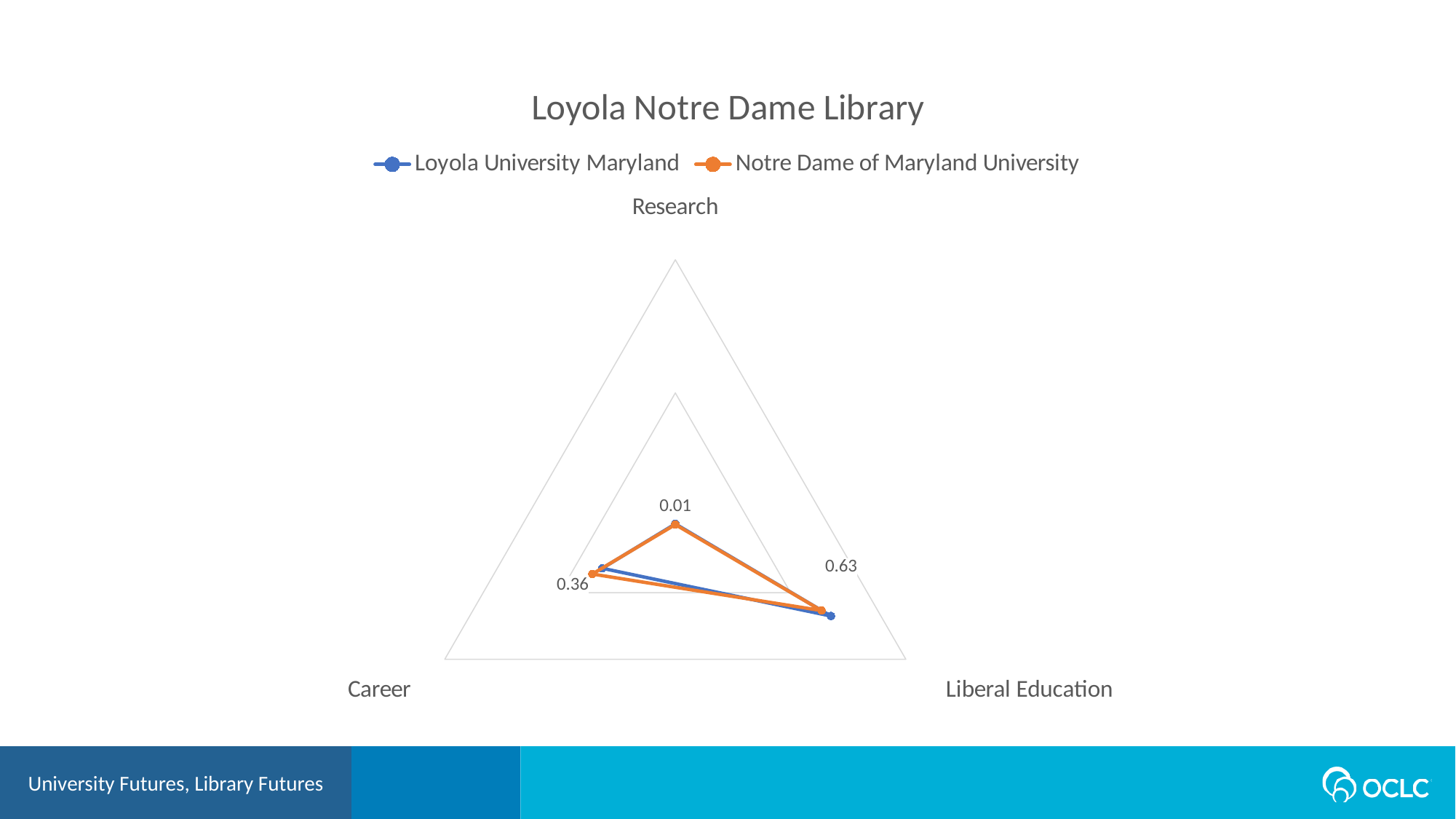
What is the difference between the labelled values for Liberal Education and Career? 0.27 What kind of chart is shown on the slide? Radar chart What data label is shown on the Career axis? 0.36 Which series is drawn in orange? Notre Dame of Maryland University Which axis has the lowest labelled value? Research For Loyola University Maryland, is the value for Liberal Education or Career larger? Liberal Education What data label is shown on the Liberal Education axis? 0.63 How many series does the legend list? 2 What is the title of the chart? Loyola Notre Dame Library How many axes (categories) does the radar chart have? 3 Which axis has the highest labelled value? Liberal Education What data label is shown on the Research axis? 0.01